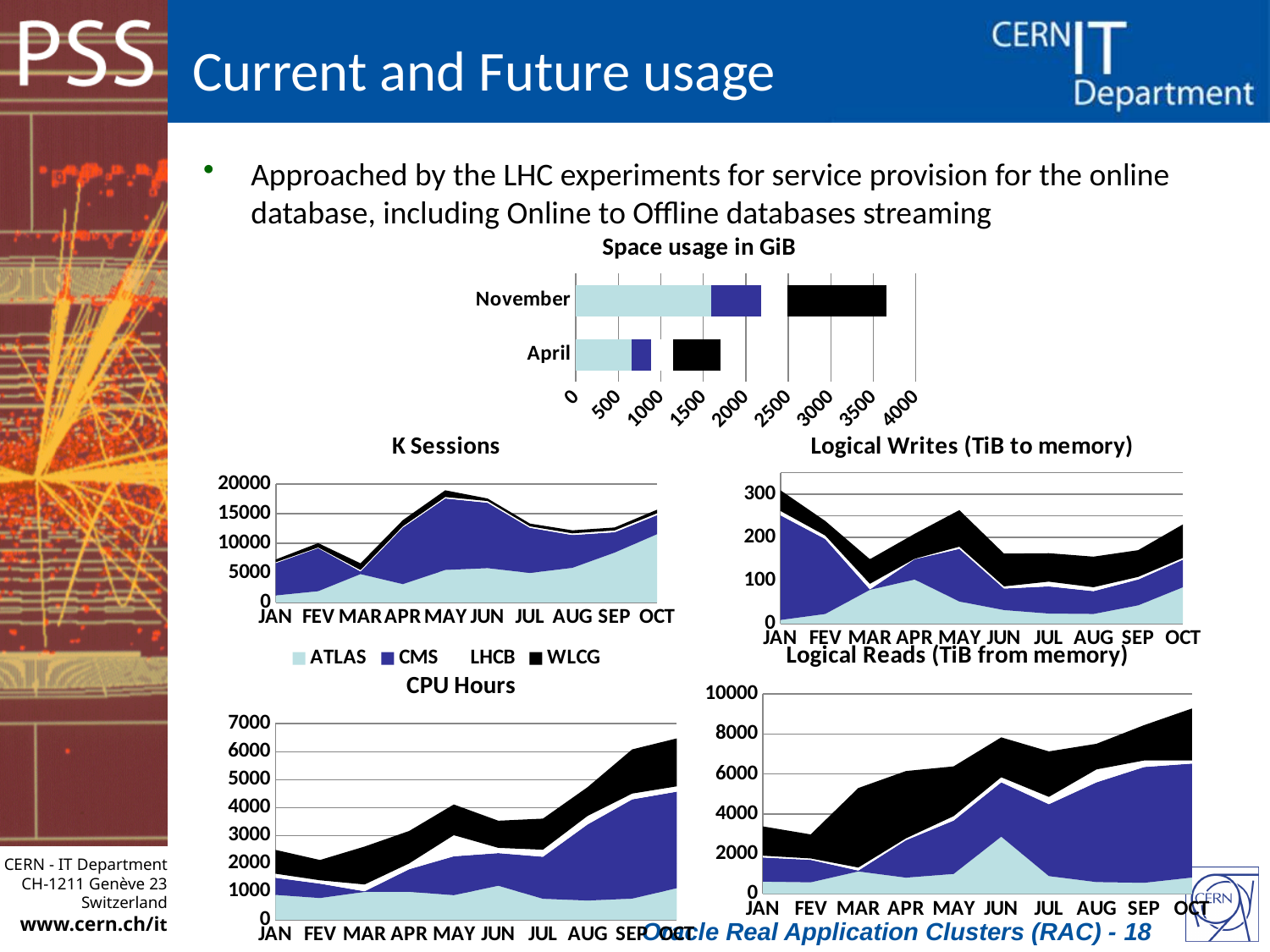
In the "CPU Hours" chart, is the total value for OCT greater or less than 6000? greater In the "Space usage in GiB" chart, how many categories are shown? 2 In the "Logical Reads (TiB from memory)" chart, do the total values generally rise or fall from JAN to OCT? rise In the "K Sessions" chart, which month has the highest total? MAY In the "Space usage in GiB" chart, which category has the larger total space usage, November or April? November In the "K Sessions" chart, is the total value for JAN greater or less than 10000? less In the "Logical Writes (TiB to memory)" chart, which month has the highest total? JAN How many series does the legend below the "K Sessions" chart list? 4 What kind of chart is the "Space usage in GiB" chart? bar chart In the "K Sessions" chart, how many months are plotted along the x axis? 10 In the "Logical Writes (TiB to memory)" chart, is the total value for JUN greater or less than 200? less Which series in the legend below the "K Sessions" chart is shown in black? WLCG